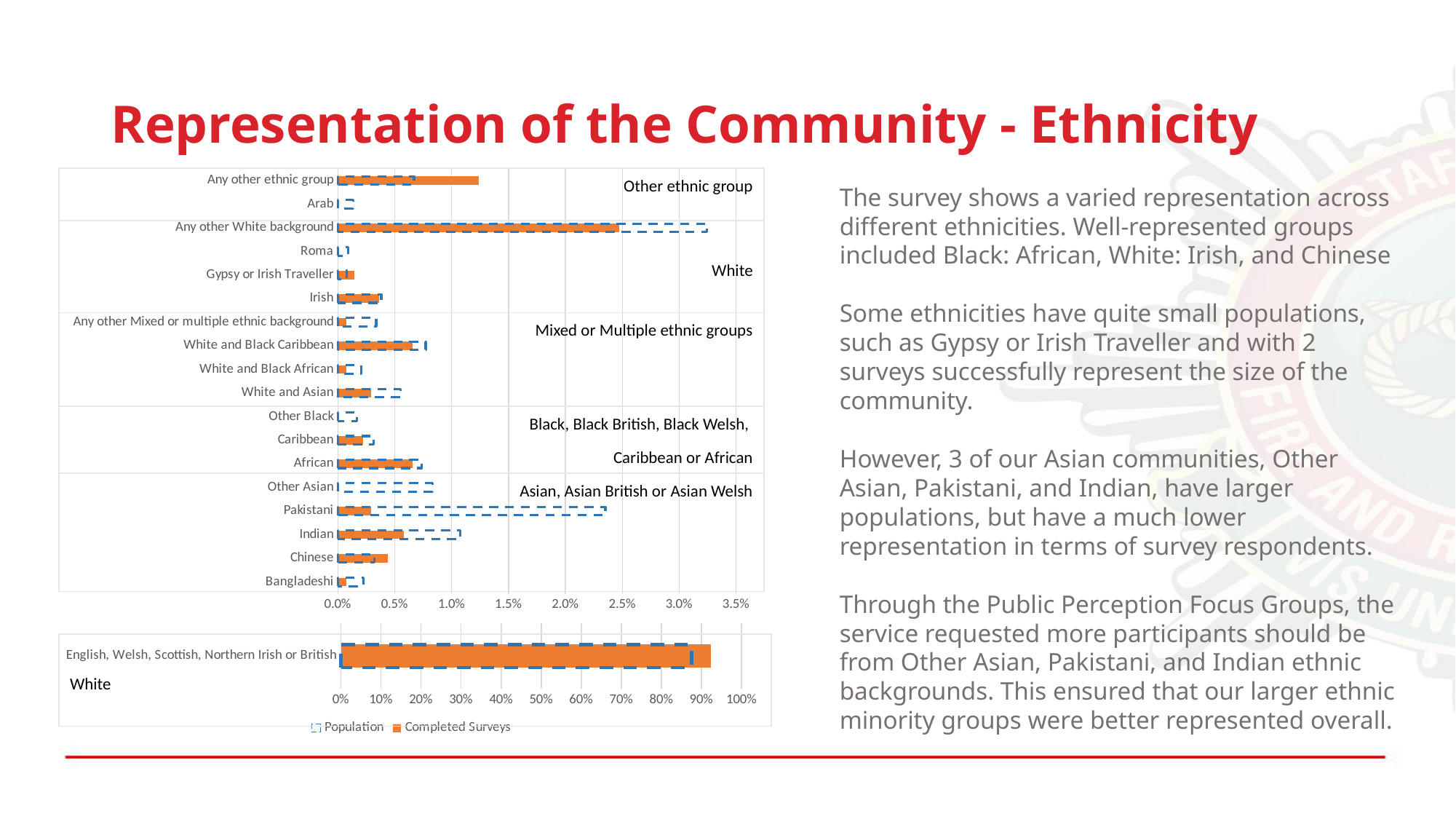
What kind of chart is the top chart on the slide? bar chart How many series does the legend list? 2 In the top chart, which category has the highest Population value? Any other White background In the top chart, for Pakistani, which is larger: Population or Completed Surveys? Population In the top chart, which category has the highest Completed Surveys value? Any other White background In the top chart, is the Population value for Pakistani greater or less than 2.0%? greater In the bottom chart, is the Completed Surveys value for English, Welsh, Scottish, Northern Irish or British greater or less than 90%? greater In the top chart, is the Population value for Any other White background greater or less than 3.0%? greater How many ethnic categories are plotted in the top chart? 18 What are the two series named in the legend? Population and Completed Surveys In the bottom chart, for English, Welsh, Scottish, Northern Irish or British, which is larger: Population or Completed Surveys? Completed Surveys